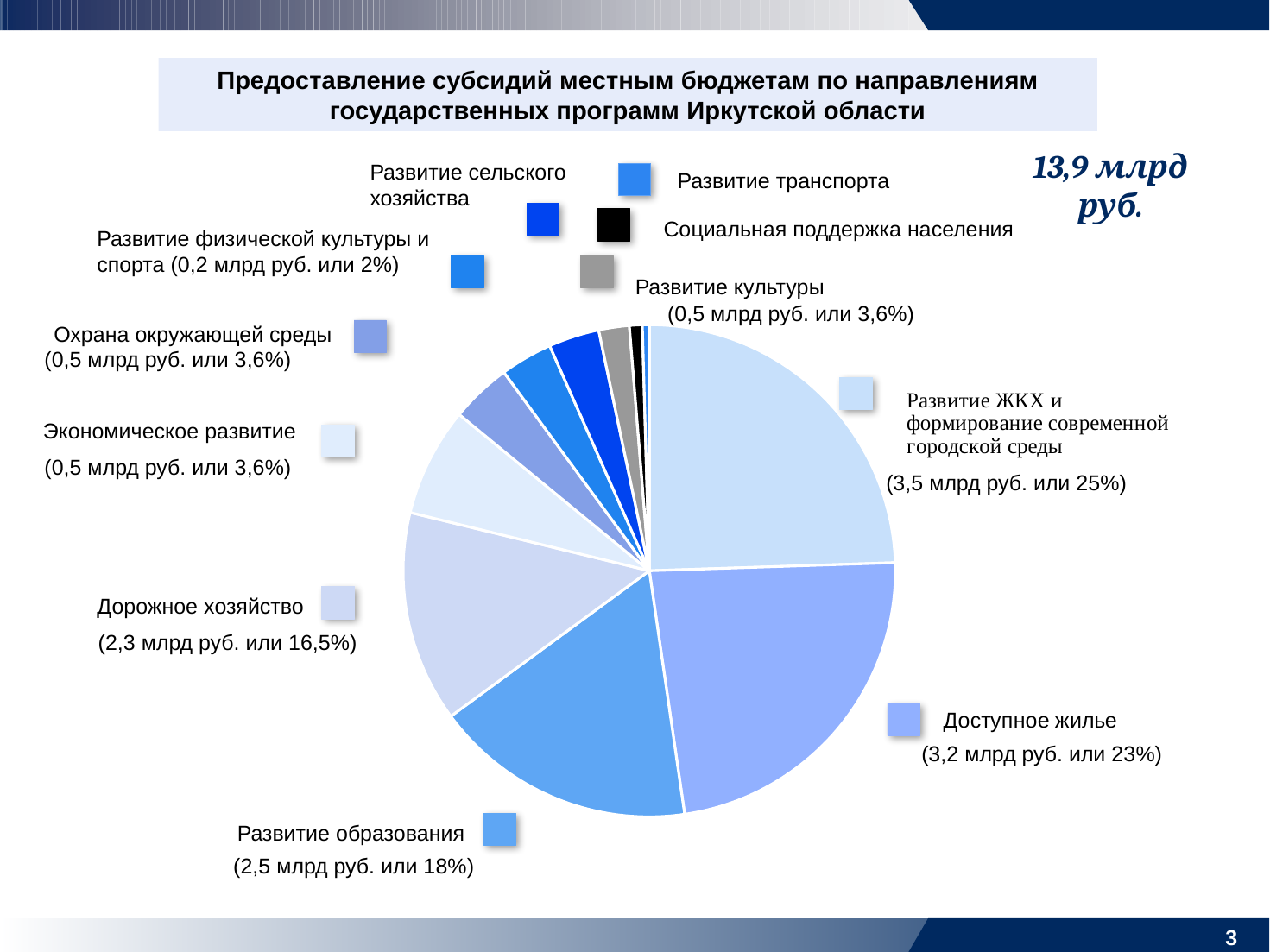
What share of the pie does Доступное жилье take? 23% Which category has the largest slice of the pie? Развитие ЖКХ и формирование современной городской среды How many categories does the pie chart have? 11 What is the difference in млрд руб. between Развитие ЖКХ и формирование современной городской среды and Доступное жилье? 0,3 млрд руб. What is the title of the slide? Предоставление субсидий местным бюджетам по направлениям государственных программ Иркутской области What is the total amount of subsidies shown on the slide? 13,9 млрд руб. What is the value for Дорожное хозяйство? 2,3 млрд руб. или 16,5% What is the value for Развитие физической культуры и спорта? 0,2 млрд руб. или 2% What is the value for Развитие ЖКХ и формирование современной городской среды? 3,5 млрд руб. или 25% What type of chart is shown on the slide? pie chart What share of the pie does Развитие образования take? 18% Which is larger, Развитие образования or Дорожное хозяйство? Развитие образования